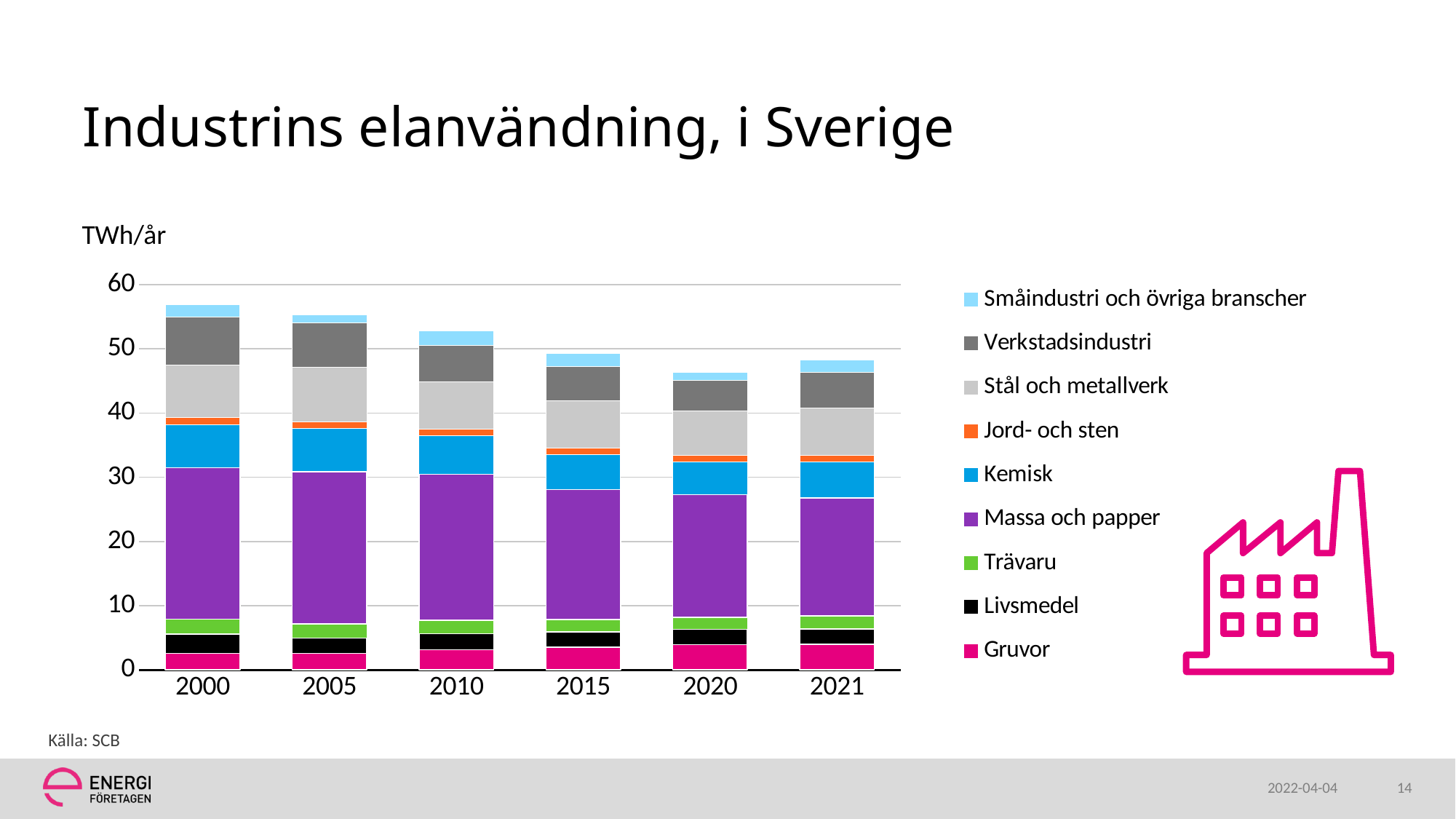
Do the total bars generally rise or fall from 2000 to 2020? fall What is the title of the chart on the slide? Industrins elanvändning, i Sverige Which year has the lowest total industrial electricity use in the chart? 2020 How many series does the chart's legend list? 9 What unit is shown on the chart's y axis? TWh/år Which year has the highest total industrial electricity use in the chart? 2000 How many years are shown on the x axis of the chart? 6 What kind of chart is shown on the slide? stacked bar chart Is the total bar for 2021 greater or less than 50 TWh/år? less Which year has the larger total bar, 2000 or 2021? 2000 Is the total bar for 2000 greater or less than 50 TWh/år? greater Is the total bar for 2020 greater or less than 50 TWh/år? less